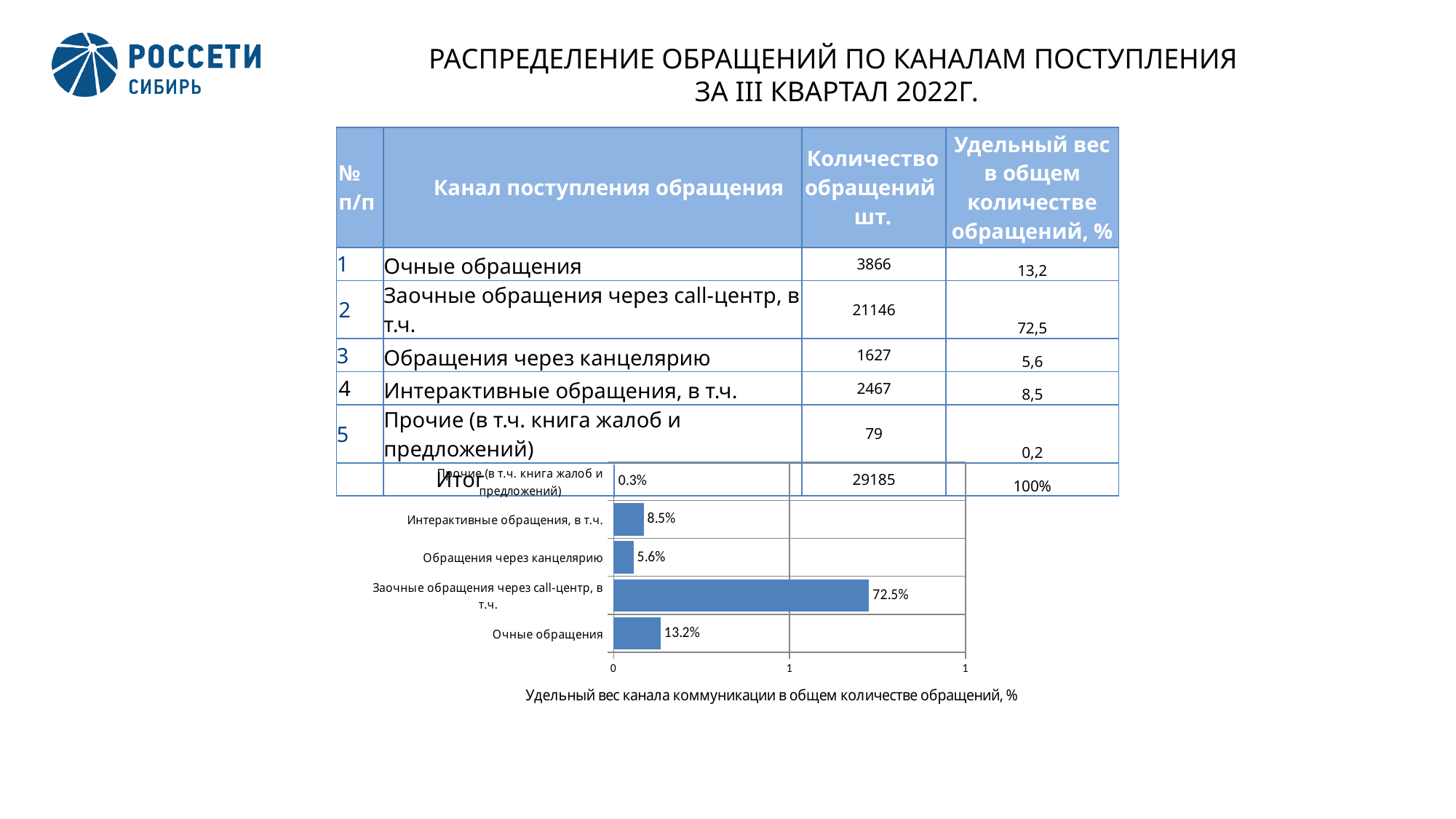
In the bar chart, what is the value for Очные обращения? 13.2% What is the axis title shown below the bar chart? Удельный вес канала коммуникации в общем количестве обращений, % How many categories are shown in the bar chart? 5 In the bar chart, what is the difference between the values for Заочные обращения через call-центр, в т.ч. and Очные обращения? 59.3% Which category has the highest value in the bar chart? Заочные обращения через call-центр, в т.ч. Which category has the lowest value in the bar chart? Прочие (в т.ч. книга жалоб и предложений) In the bar chart, what is the value for Прочие (в т.ч. книга жалоб и предложений)? 0.3% What type of chart is shown on the slide? bar chart In the bar chart, which is larger: the value for Интерактивные обращения, в т.ч. or the value for Обращения через канцелярию? Интерактивные обращения, в т.ч. In the bar chart, what is the value for Заочные обращения через call-центр, в т.ч.? 72.5% In the bar chart, what is the value for Интерактивные обращения, в т.ч.? 8.5% In the bar chart, what is the value for Обращения через канцелярию? 5.6%